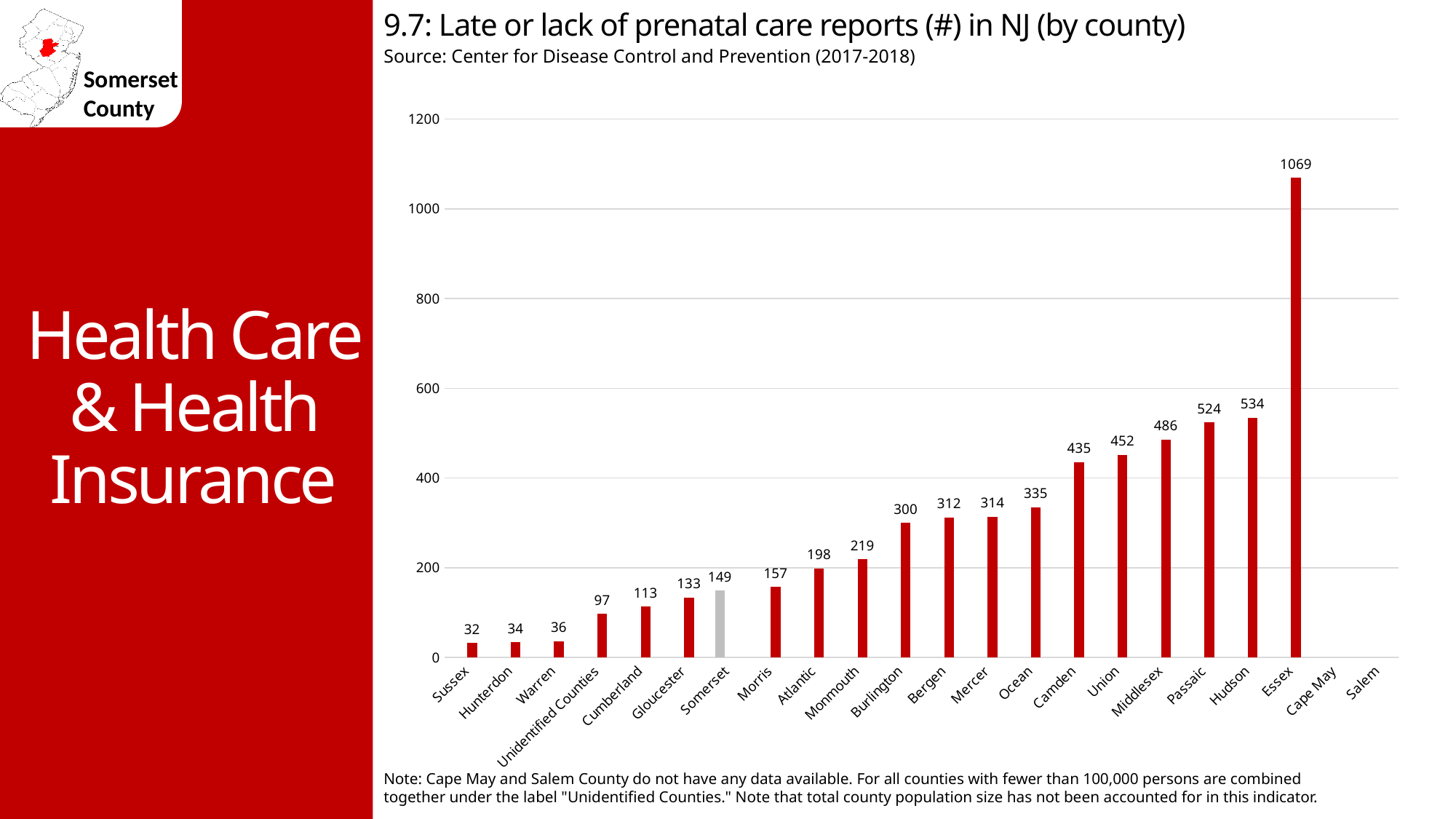
What is the value shown for Essex? 1069 How many categories are listed on the x axis? 22 What kind of chart is shown on the slide? Bar chart Is the value for Middlesex greater or less than 400? greater Which county has the highest number of reports? Essex What is the difference between the values for Hudson and Passaic? 10 What is the number of late or lack of prenatal care reports for Somerset? 149 Among the counties with a plotted bar, which has the lowest number of reports? Sussex Which has a larger value, Camden or Ocean? Camden Do the values generally rise or fall from left to right along the x axis? Rise What is the value shown for Burlington? 300 Which bar is coloured grey instead of red? Somerset